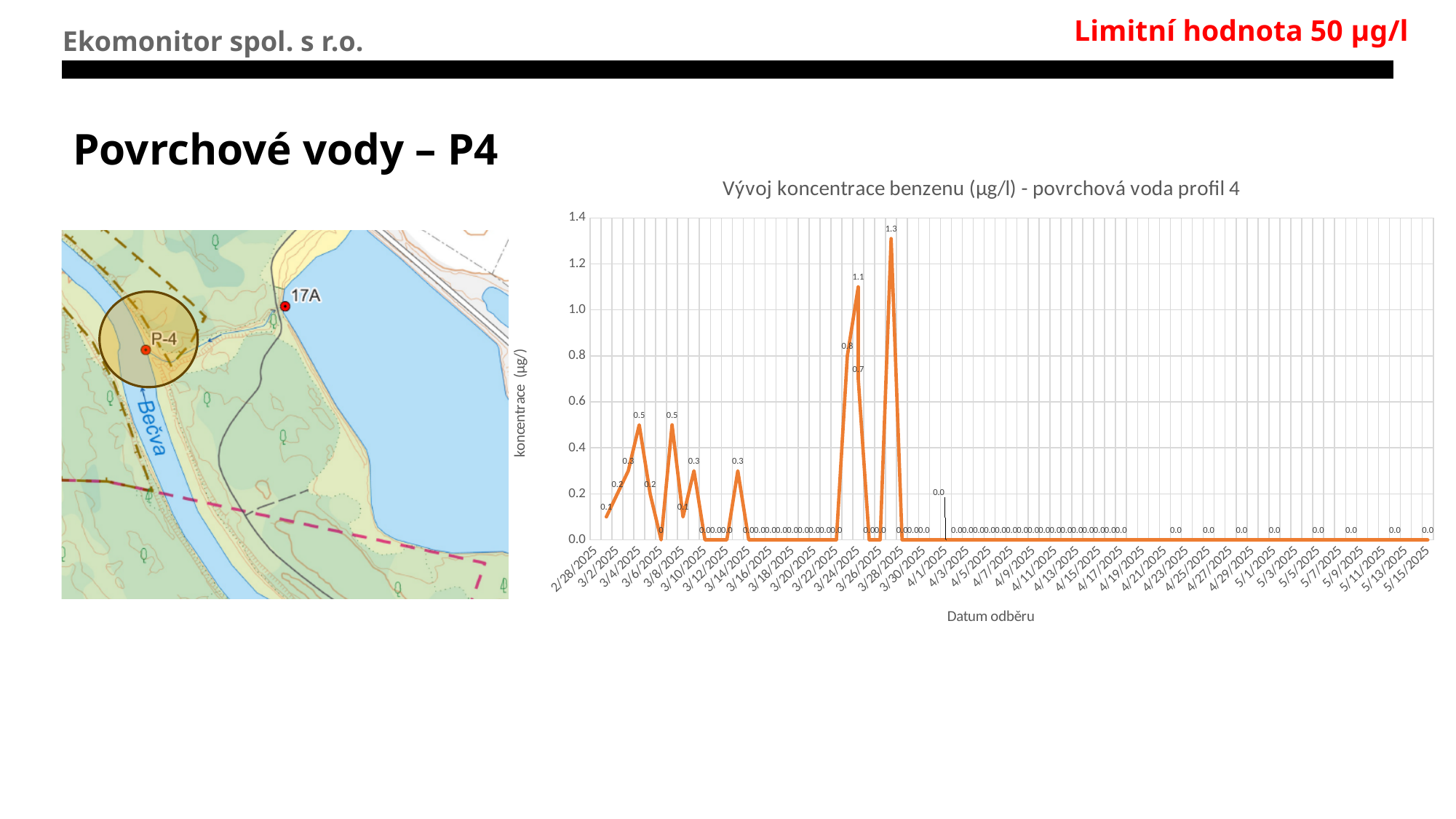
What is the difference between the two highest peaks on the chart, labelled 1.3 and 1.1? 0.2 Do the plotted values rise or fall between the 1.3 peak and the end of the chart? fall What is the concentration value plotted for 5/15/2025, the last date on the chart? 0.0 What is the label of the vertical axis of the chart? koncentrace (µg/l) What is the highest value shown on the vertical axis of the chart? 1.4 What kind of chart is shown on the slide? line chart What is the title of the chart? Vývoj koncentrace benzenu (µg/l) - povrchová voda profil 4 What is the highest benzene concentration value plotted on the chart? 1.3 What is the lowest concentration value plotted on the chart? 0.0 Is the highest value on the chart greater or less than 1.2? greater